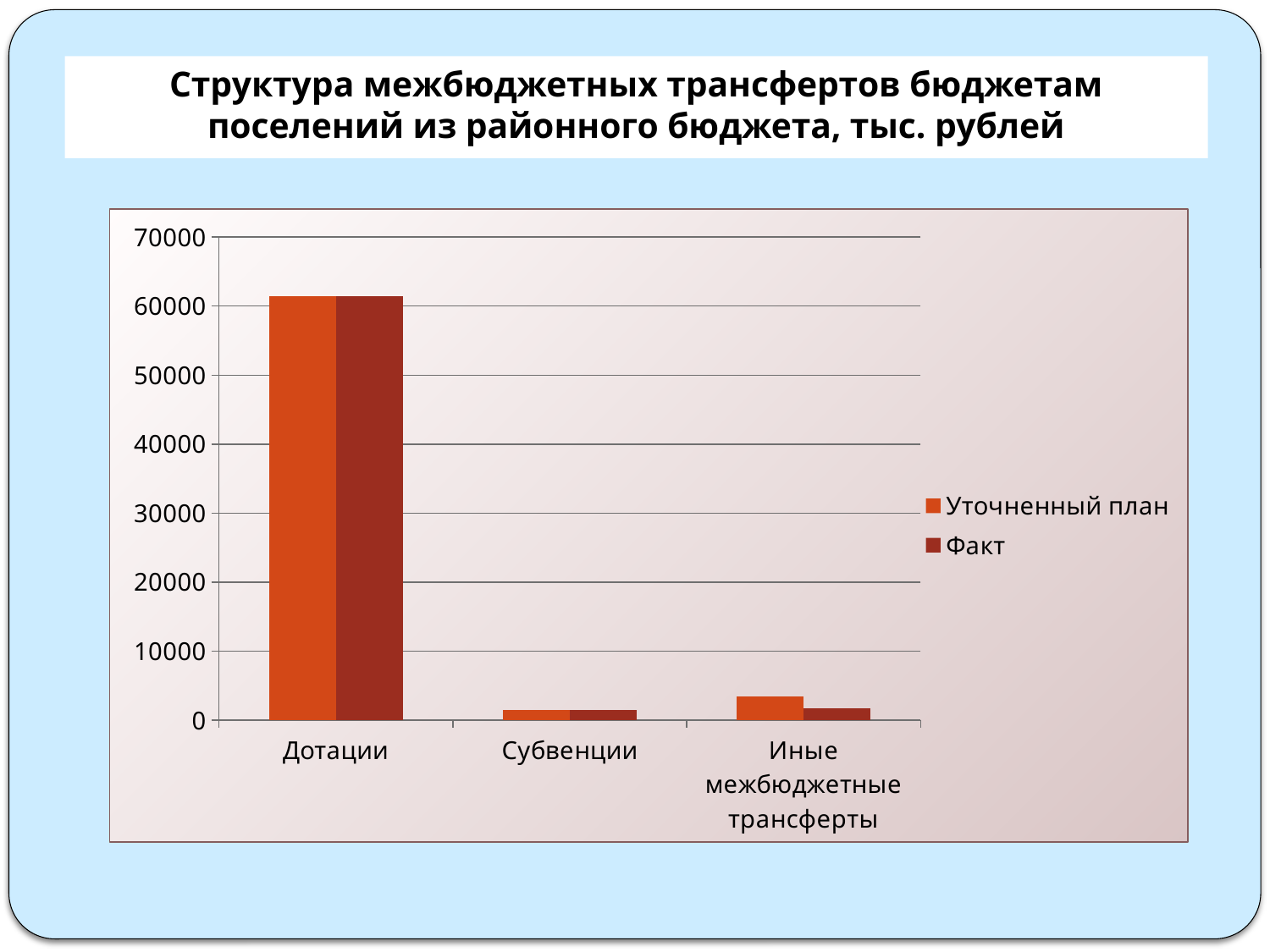
Is the value for Дотации (Уточненный план) greater or less than 60000? greater Is the value for Дотации (Факт) greater or less than 70000? less Which series is shown in the darker red colour in the legend? Факт For Иные межбюджетные трансферты, which is larger: Уточненный план or Факт? Уточненный план Which category has the highest value for Уточненный план? Дотации Is the value for Субвенции (Факт) greater or less than 10000? less How many series does the legend list? 2 What kind of chart is shown on the slide? bar chart Which category has the lowest value for Уточненный план? Субвенции What is the title of the chart on the slide? Структура межбюджетных трансфертов бюджетам поселений из районного бюджета, тыс. рублей How many categories are shown on the x axis of the chart? 3